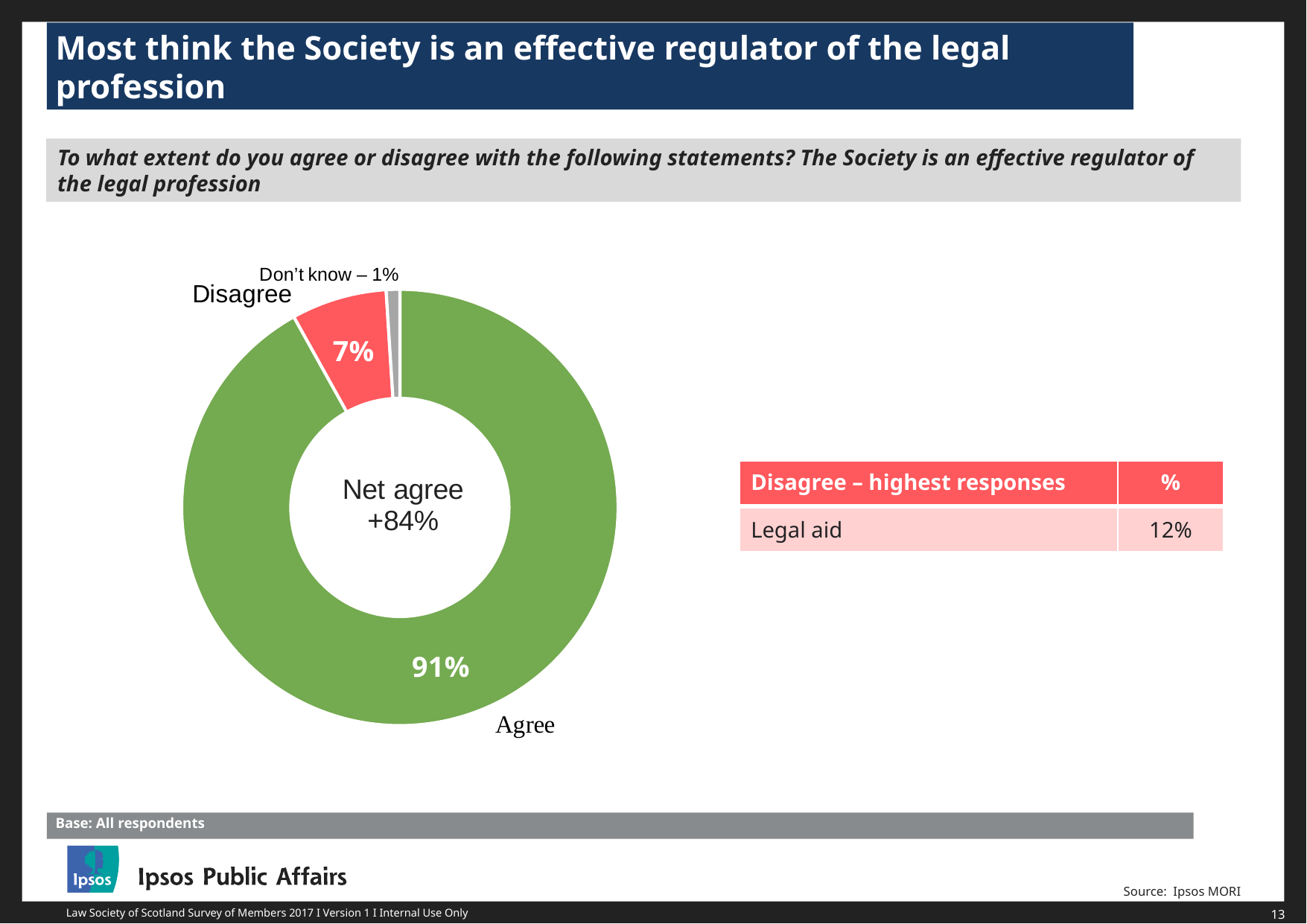
What percentage of respondents disagree? 7% In the table, what percentage of Legal aid respondents disagree? 12% How many response categories are shown in the chart? 3 Which is larger, the Disagree share or the Don't know share? Disagree What percentage of respondents agree that the Society is an effective regulator of the legal profession? 91% What is the net agree figure shown in the centre of the chart? +84% Which response has the largest share of the chart? Agree What percentage of respondents answered 'Don't know'? 1% What kind of chart is shown on the slide? Pie chart (doughnut) Which response has the smallest share of the chart? Don't know What is the difference in percentage points between Agree and Disagree? 84 What colour is the Agree segment of the chart? Green